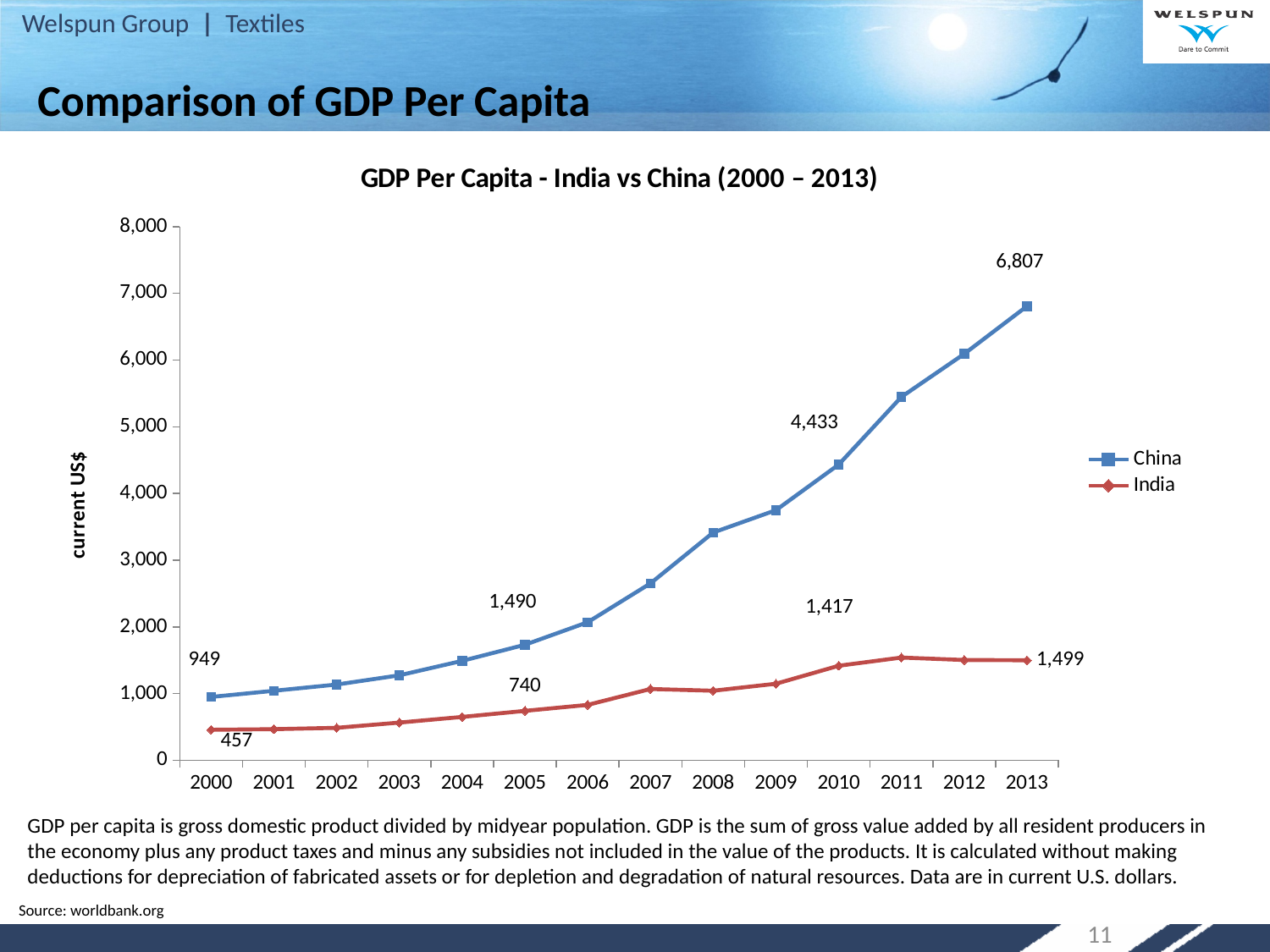
What is China's GDP per capita in 2010? 4,433 Does China's GDP per capita rise or fall from 2000 to 2013? rise What is India's GDP per capita in 2000? 457 How many series does the legend list? 2 What is the title of the chart? GDP Per Capita - India vs China (2000 – 2013) What type of chart is shown on the slide? line chart How many years are shown on the x axis? 14 Which country has the higher GDP per capita in 2010? China What is India's GDP per capita in 2005? 740 What is China's GDP per capita in 2013? 6,807 Is China's GDP per capita in 2008 greater or less than 3,000? greater What is the difference between China's and India's GDP per capita in 2013? 5,308